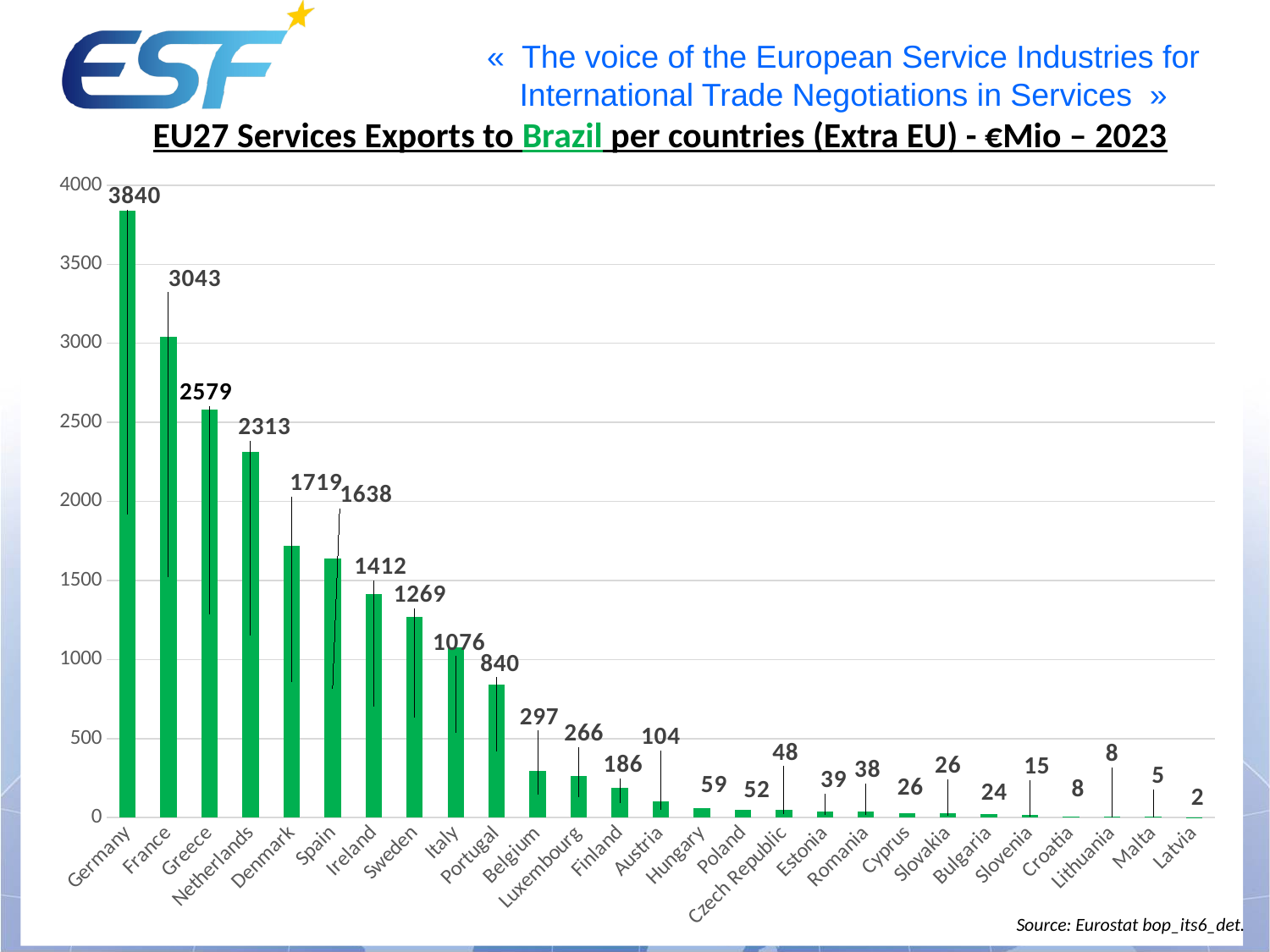
What is the title of the chart? EU27 Services Exports to Brazil per countries (Extra EU) - €Mio – 2023 What is the value for Germany? 3840 How many countries are shown on the x axis? 27 Is the value for Italy greater or less than 1000? greater What kind of chart is this? Bar chart What is the value for Czech Republic? 48 Which country has the highest value? Germany Do the values rise or fall from left to right along the x axis? Fall What is the difference between the values for France and Greece? 464 Which country has the lowest value? Latvia Which is larger, the value for Denmark or the value for Spain? Denmark What is the value for Portugal? 840